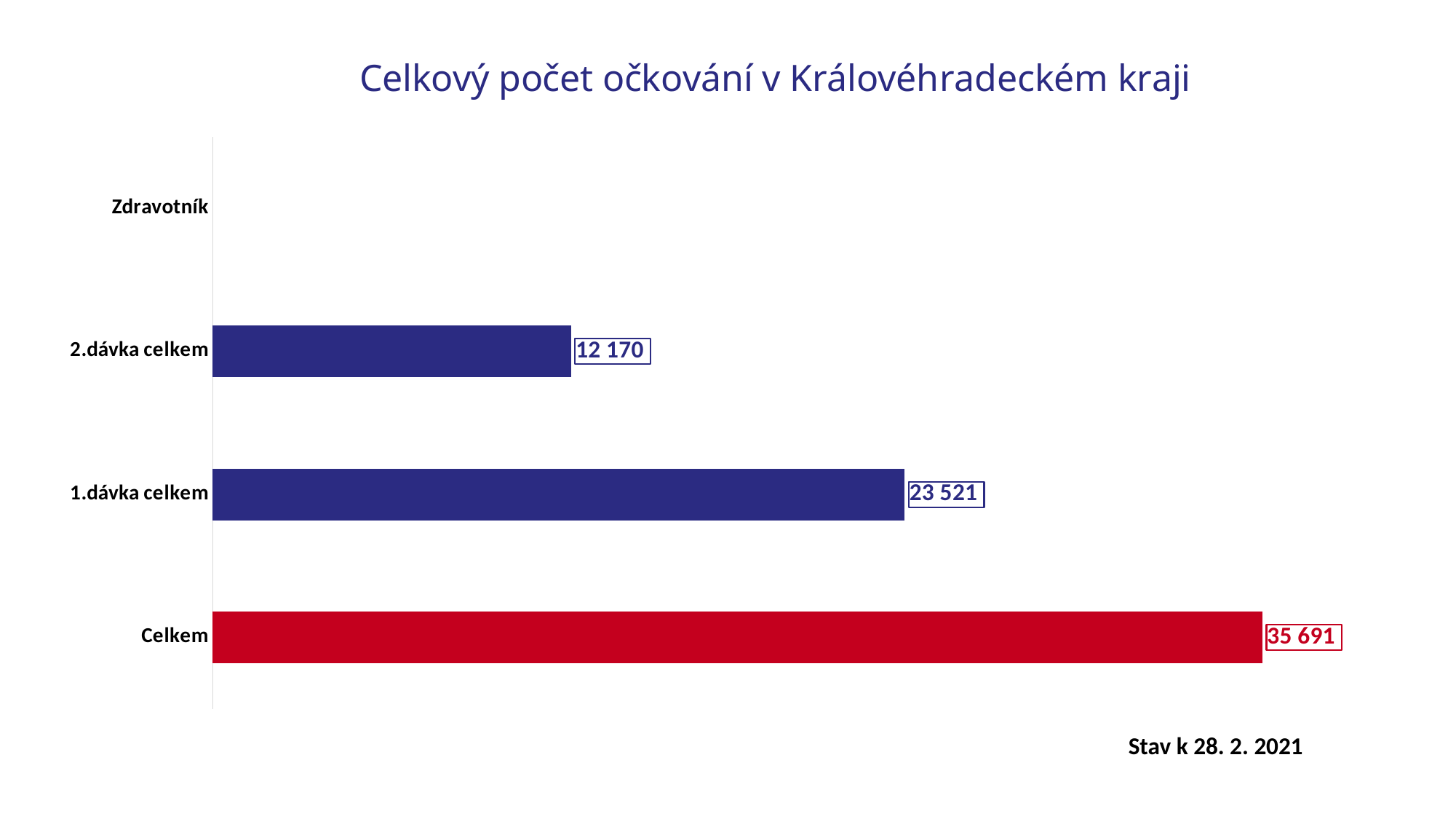
How many bars are plotted on the chart? 3 What is the difference between the values for "Celkem" and "1.dávka celkem"? 12 170 What is the value for "2.dávka celkem"? 12 170 What colour is the bar for "Celkem"? red What is the value for "Celkem"? 35 691 Which category has the highest value? Celkem What is the difference between the values for "1.dávka celkem" and "2.dávka celkem"? 11 351 Which of the plotted bars has the lowest value? 2.dávka celkem What is the value for "1.dávka celkem"? 23 521 Which is larger, the value for "1.dávka celkem" or the value for "2.dávka celkem"? 1.dávka celkem What is the title of the chart? Celkový počet očkování v Královéhradeckém kraji What type of chart is shown on the slide? bar chart